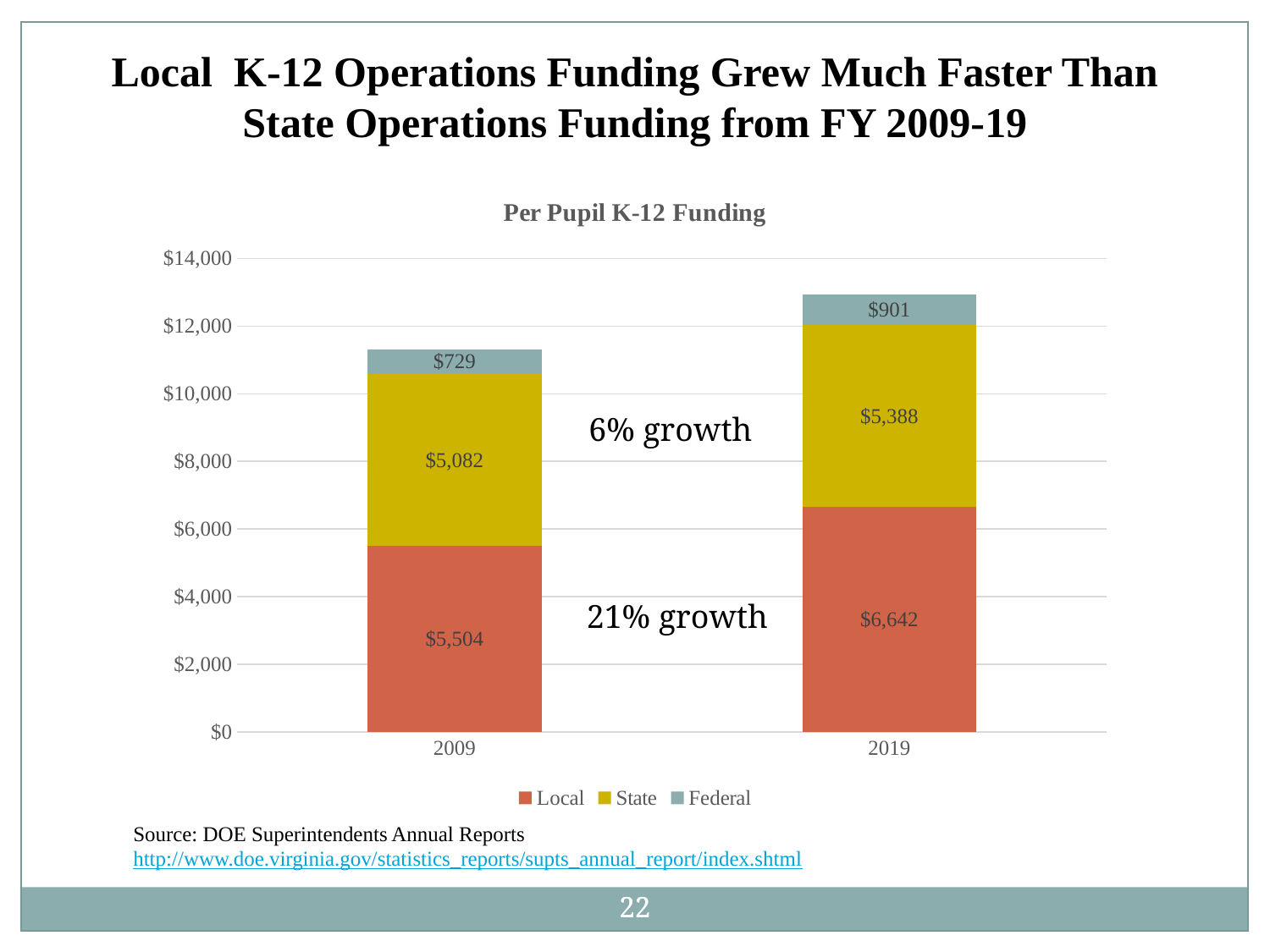
What type of chart is shown on the slide? Stacked bar chart What is the State per pupil funding value for 2019? $5,388 Is the total height of the 2019 bar greater or less than $12,000? greater What is the Federal per pupil funding value for 2009? $729 How many series does the legend list? 3 What is the total per pupil funding for the 2019 stacked bar? $12,931 What is the Federal per pupil funding value for 2019? $901 Which is larger in 2009, Local funding or State funding? Local What is the total per pupil funding for the 2009 stacked bar? $11,315 What is the Local per pupil funding value for 2009? $5,504 By how much did Local per pupil funding increase from 2009 to 2019? $1,138 What is the difference between State per pupil funding in 2019 and in 2009? $306